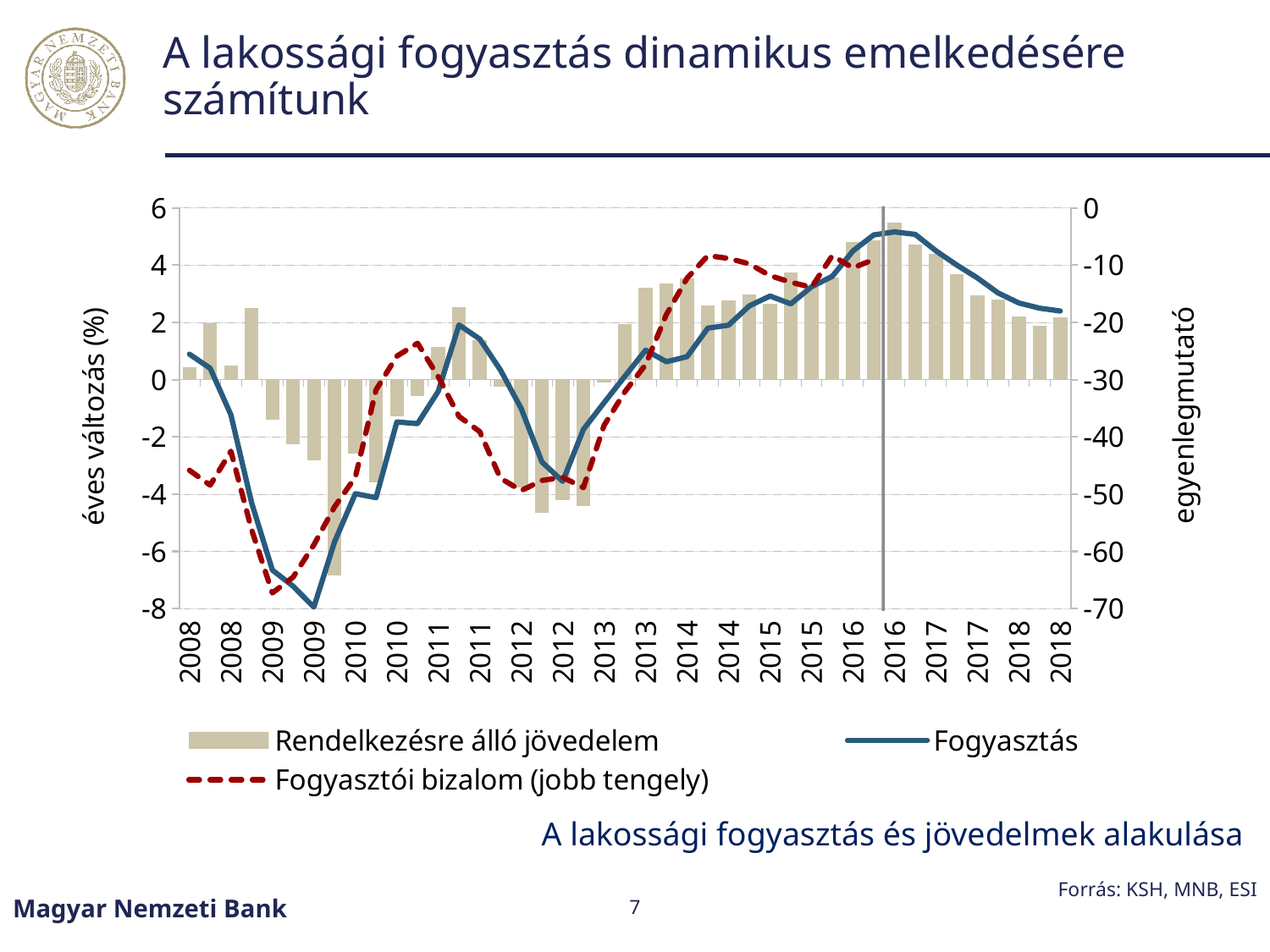
Is the peak value of the Fogyasztás line, in 2016, greater or less than 4? greater Is the lowest value of the Fogyasztás line, in 2009, greater or less than -6? less Which is larger: the Fogyasztás value in 2009 or in 2016? 2016 Does the Fogyasztás line rise or fall between 2016 and 2018? fall In which year does the Rendelkezésre álló jövedelem bar reach its lowest value? 2009 How many series does the legend list? 3 What is the title of the chart? A lakossági fogyasztás és jövedelmek alakulása What is the last year shown on the x axis? 2018 Which series is plotted on the right axis according to the legend? Fogyasztói bizalom (jobb tengely) Do the Rendelkezésre álló jövedelem bars rise or fall between 2012 and 2016? rise What kind of chart is shown on the slide? A combined bar and line chart What is the first year shown on the x axis? 2008